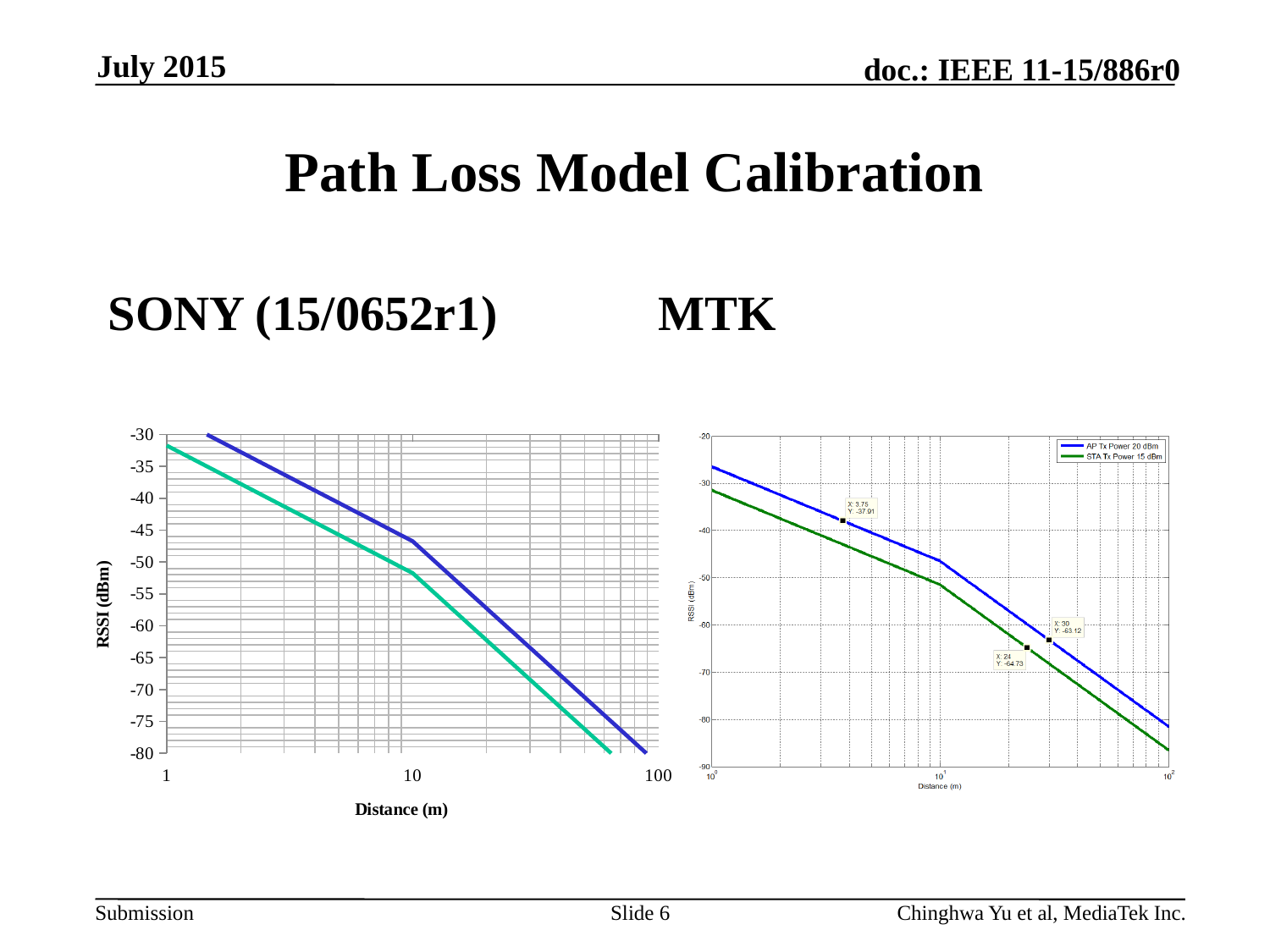
In the SONY (15/0652r1) chart on the left, is the RSSI of the teal line at 1 m greater or less than -35? greater What kind of chart is the SONY (15/0652r1) chart on the left? line chart How many series does the legend of the MTK chart on the right list? 2 In the MTK chart on the right, which series has the higher RSSI values, AP Tx Power 20 dBm or STA Tx Power 15 dBm? AP Tx Power 20 dBm In the MTK chart on the right, what RSSI value is marked at X = 30? -63.12 In the MTK chart on the right, what RSSI value is marked at X = 3.75? -37.91 In the SONY (15/0652r1) chart on the left, is the RSSI of the blue line at 10 m greater or less than -50? greater In the MTK chart on the right, what RSSI value is marked at X = 24? -64.73 In the SONY (15/0652r1) chart on the left, do the RSSI values rise or fall as distance increases? fall What are the two legend entries in the MTK chart on the right? AP Tx Power 20 dBm and STA Tx Power 15 dBm In the SONY (15/0652r1) chart on the left, is the RSSI of the teal line at 10 m greater or less than -45? less In the SONY (15/0652r1) chart on the left, which line has the higher RSSI values, the blue line or the teal line? the blue line